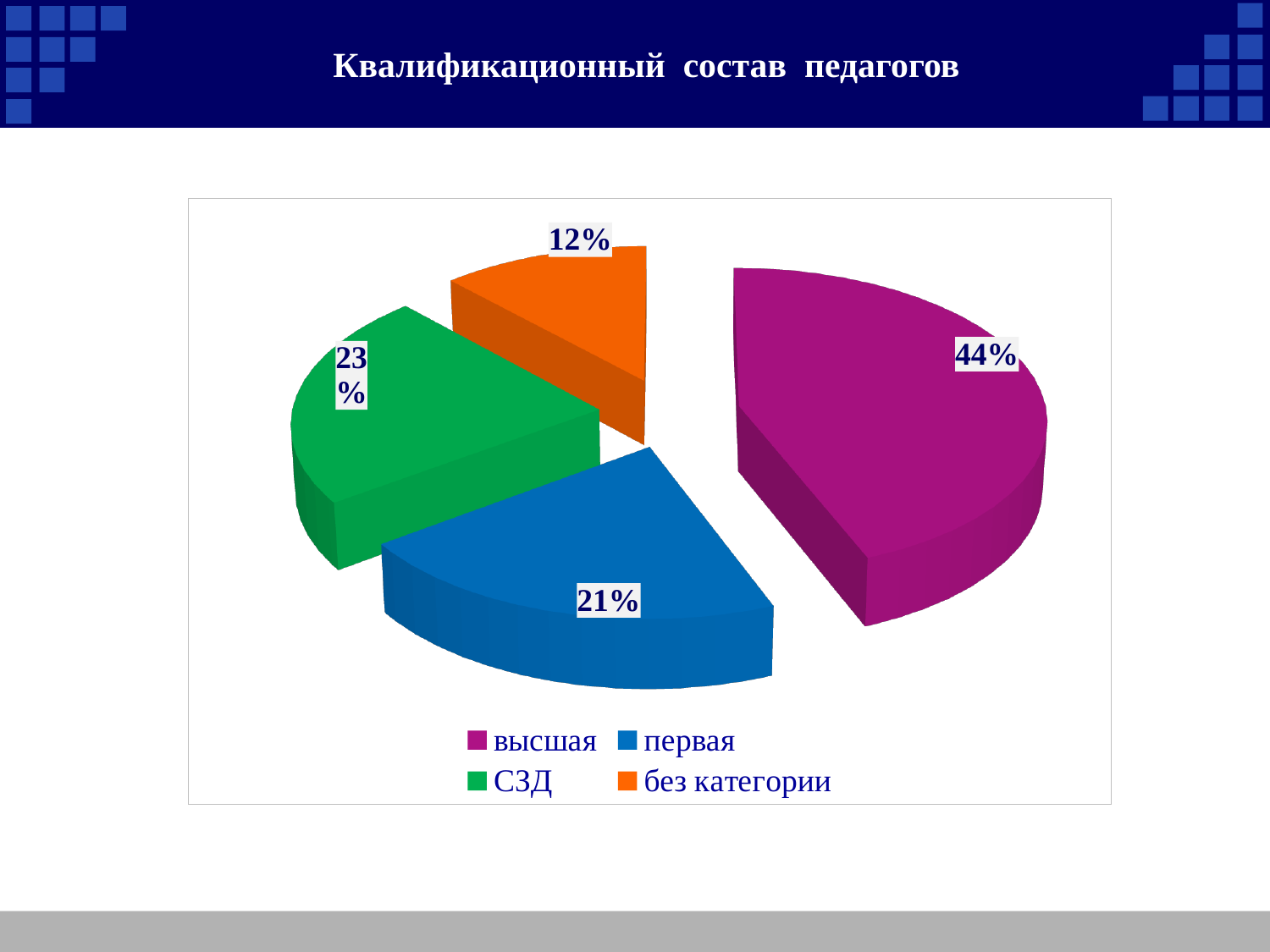
What kind of chart is shown on the slide? pie chart What share of the pie does the 'первая' category have? 21% How many categories are shown in the pie chart? 4 Which is larger, the share of 'СЗД' or the share of 'первая'? СЗД Which category has the largest share of the pie? высшая What share of the pie does the 'высшая' category have? 44% What is the difference between the shares of 'высшая' and 'первая'? 23% Which colour represents the 'без категории' category in the legend? orange Which category has the smallest share of the pie? без категории What share of the pie does the 'СЗД' category have? 23% What share of the pie does the 'без категории' category have? 12% What is the title of the slide? Квалификационный состав педагогов